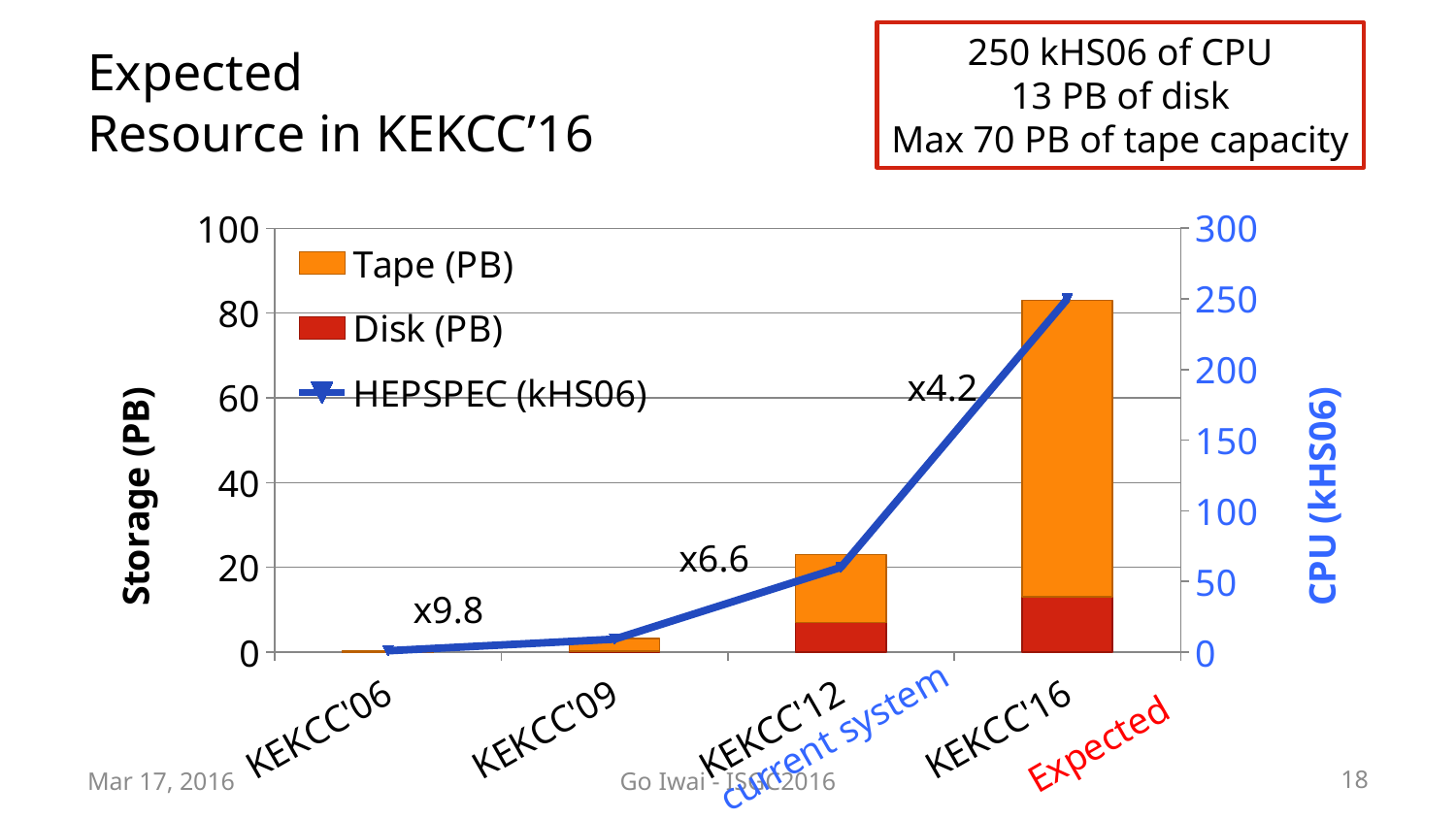
How many categories are shown on the x axis of the chart? 4 Is the total storage for KEKCC'16 greater or less than 60 PB? greater What growth factor is annotated on the chart between KEKCC'12 and KEKCC'16? x4.2 Is the total storage for KEKCC'12 greater or less than 40 PB? less Do the HEPSPEC values rise or fall from KEKCC'06 to KEKCC'16? Rise Which category has the lowest HEPSPEC value? KEKCC'06 What kind of chart is shown on the slide? A stacked bar chart combined with a line chart Which category has the highest total storage? KEKCC'16 How many series does the chart legend list? 3 What is the title of the right-hand vertical axis? CPU (kHS06) Which has the larger total storage, KEKCC'09 or KEKCC'12? KEKCC'12 Is the HEPSPEC value for KEKCC'16 greater or less than 200 kHS06? greater